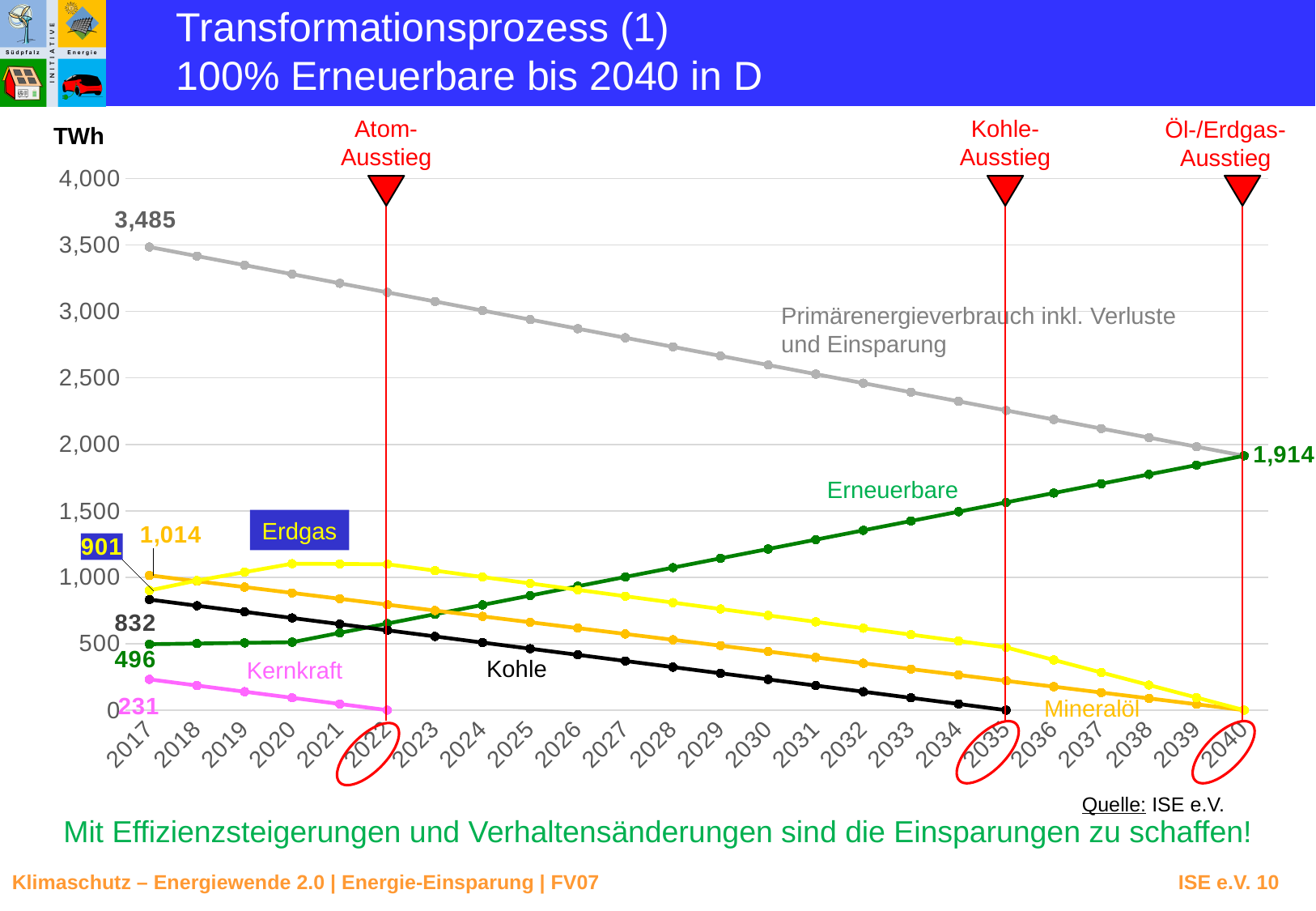
By how much does the Erneuerbare value increase from 2017 to 2040? 1,418 In which year is the Atom-Ausstieg marked on the chart? 2022 What value does the Erneuerbare line reach in 2040? 1,914 Is the value for Erdgas in 2022 greater or less than 1,000? greater What is the value of Primärenergieverbrauch inkl. Verluste und Einsparung in 2017? 3,485 What is the value of Erneuerbare in 2017? 496 What is the value of Kohle in 2017? 832 How many years are shown on the x axis? 24 What is the value of Kernkraft in 2017? 231 In 2017, which is larger: Mineralöl or Erdgas? Mineralöl Does the Primärenergieverbrauch line rise or fall from 2017 to 2040? fall What is the value of Mineralöl in 2017? 1,014